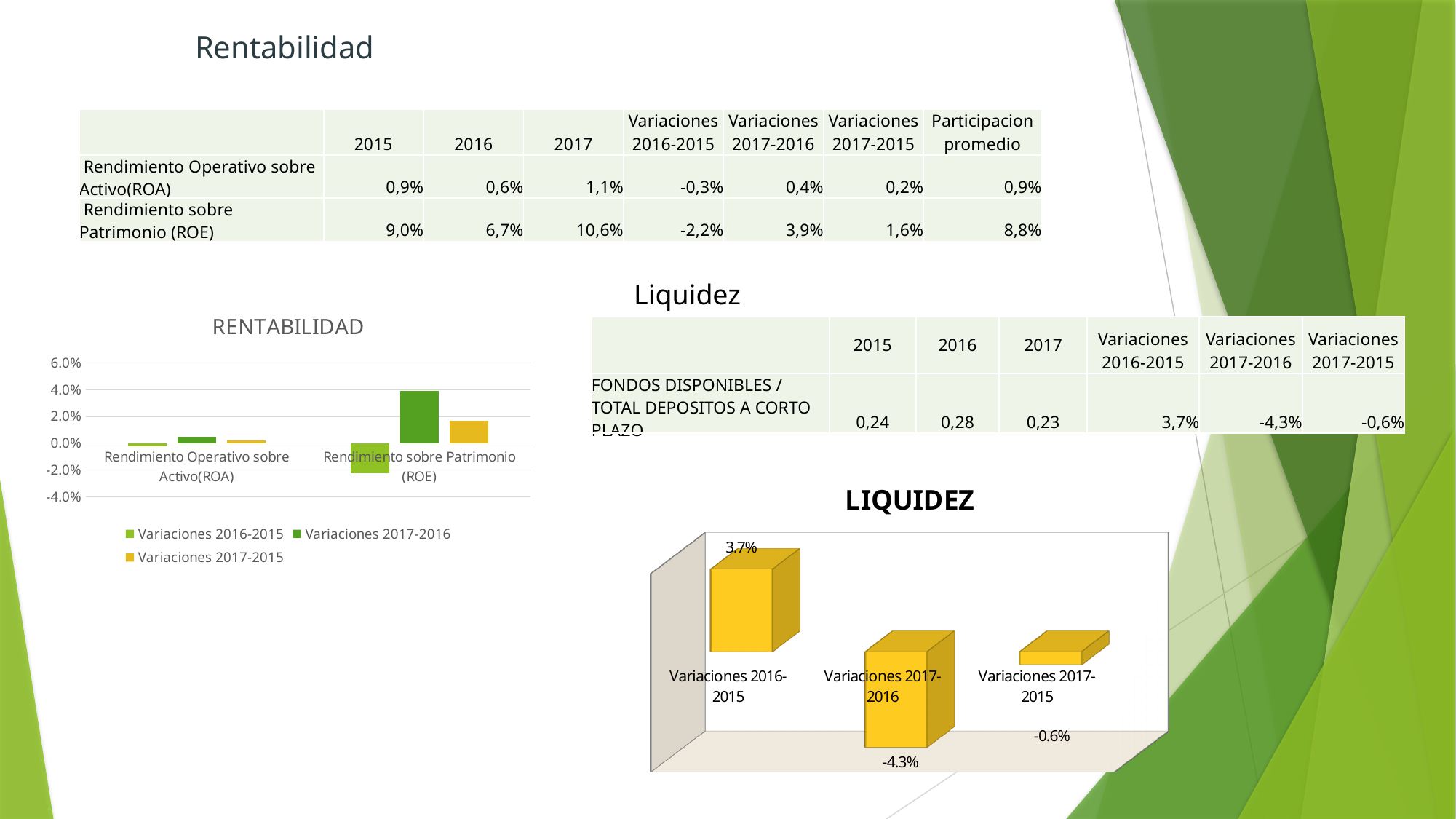
On the LIQUIDEZ chart, how many bars are plotted? 3 On the RENTABILIDAD chart, how many series does the legend list? 3 What kind of chart is the LIQUIDEZ chart? Bar chart On the LIQUIDEZ chart, what is the value for Variaciones 2017-2016? -4.3% On the LIQUIDEZ chart, what is the difference between the values for Variaciones 2016-2015 and Variaciones 2017-2015? 4.3% On the LIQUIDEZ chart, which category has the lowest value? Variaciones 2017-2016 On the RENTABILIDAD chart, is the Variaciones 2016-2015 value for Rendimiento sobre Patrimonio (ROE) greater or less than 0.0%? less On the LIQUIDEZ chart, what is the value for Variaciones 2016-2015? 3.7% On the RENTABILIDAD chart, which series is shown in yellow according to the legend? Variaciones 2017-2015 On the LIQUIDEZ chart, what is the value for Variaciones 2017-2015? -0.6% On the RENTABILIDAD chart, is the Variaciones 2017-2016 value for Rendimiento sobre Patrimonio (ROE) greater or less than 2.0%? greater On the LIQUIDEZ chart, which category has the highest value? Variaciones 2016-2015